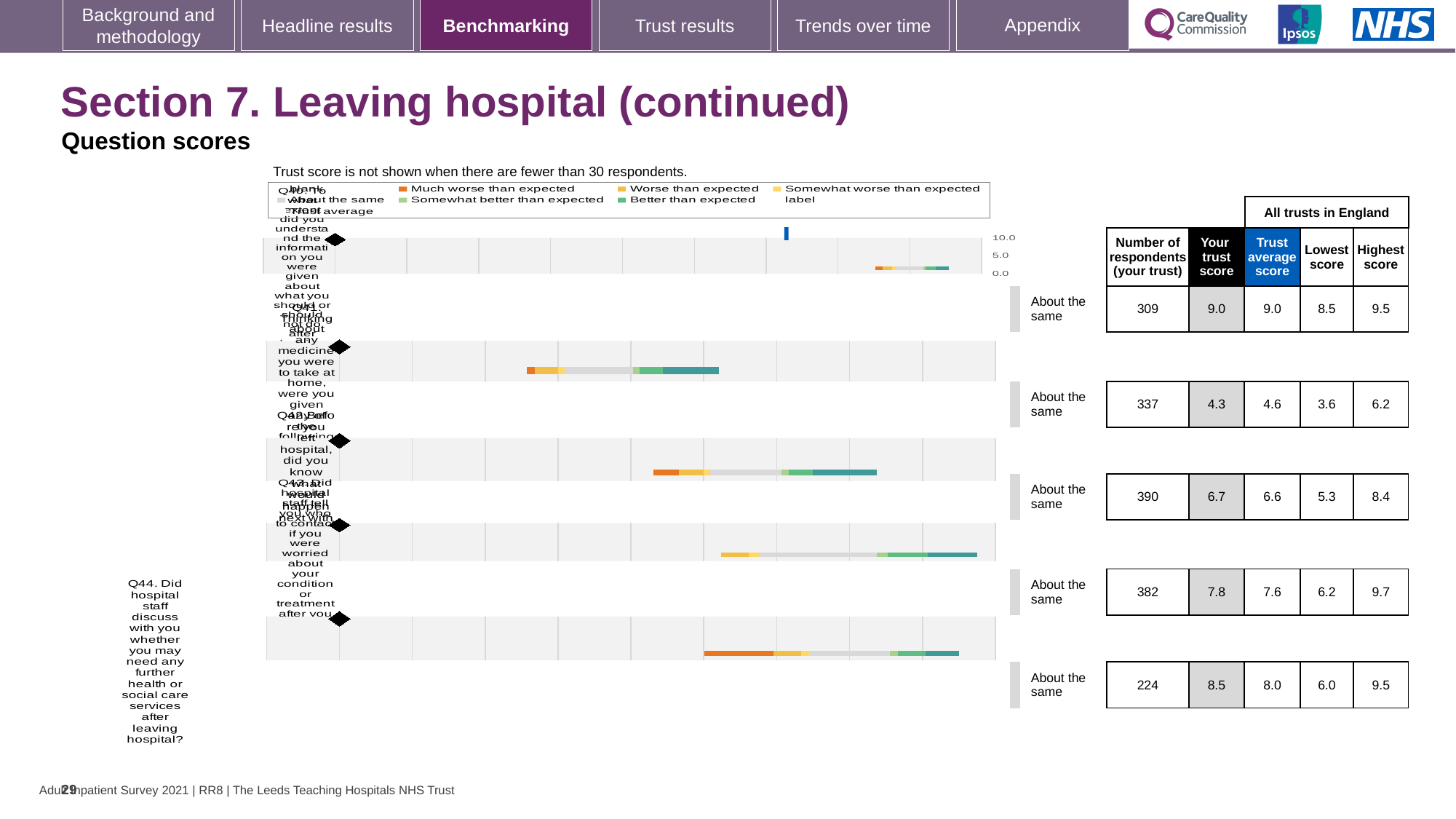
In the table, what is the number of respondents for Q44 (the last row)? 224 For Q44 (the last row), is 'Your trust score' higher or lower than the trust average score? higher In the table, what is 'Your trust score' for Q44 (the last row)? 8.5 Which legend entry is shown in orange? Much worse than expected What kind of chart is used to show the question scores on this slide? bar chart What is the lowest 'Your trust score' value shown in the table? 4.3 In the table, what is the trust average score for Q44 (the last row)? 8.0 How many question rows (bars) are plotted in the chart? 5 What is the highest 'Your trust score' value shown in the table? 9.0 For Q44 (the last row), what is the difference between the highest score and the lowest score across all trusts in England? 3.5 What benchmark category is shown for Q44 (the last row)? About the same According to the note above the chart, when is the trust score not shown? When there are fewer than 30 respondents